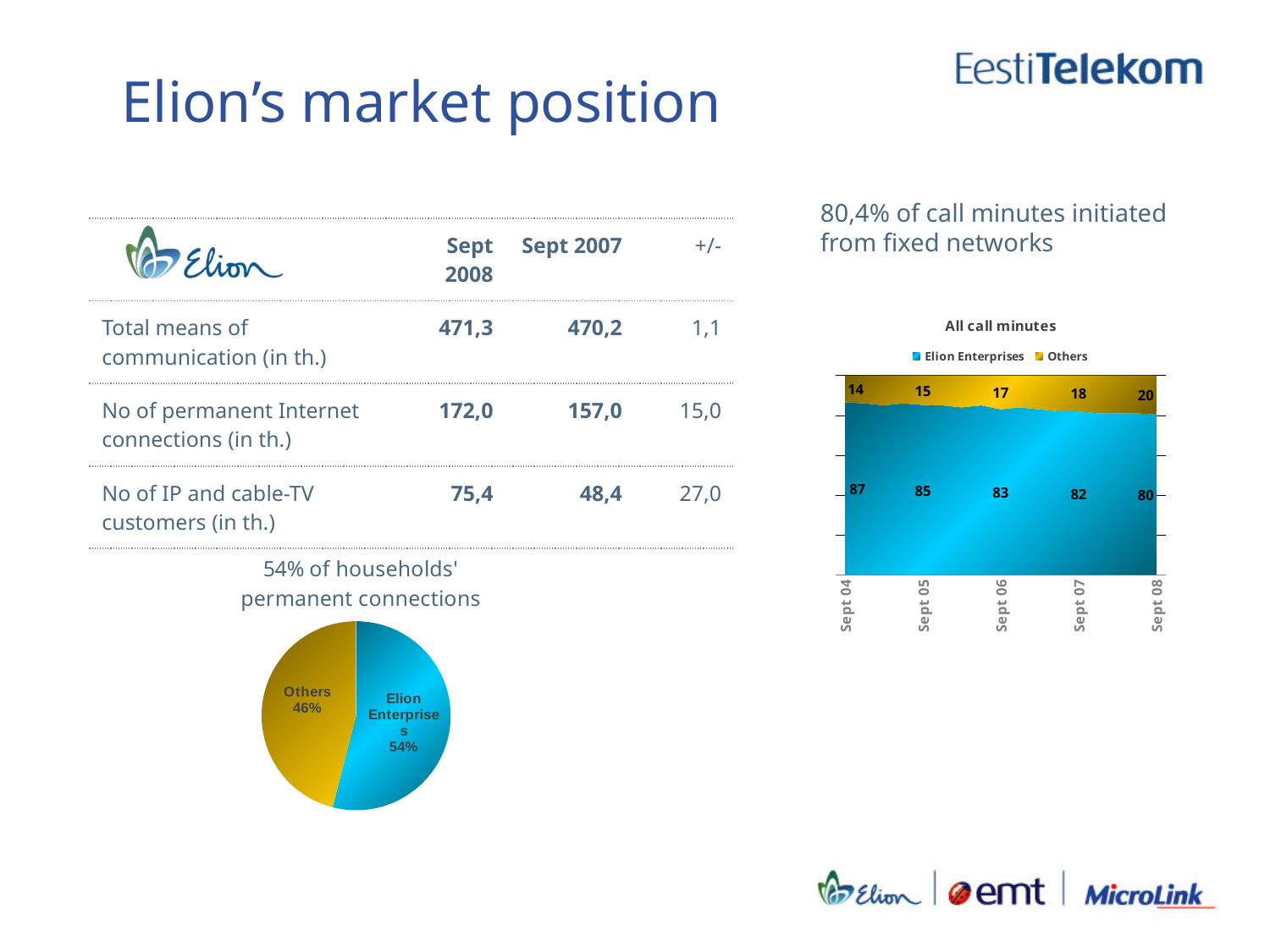
What kind of chart is the chart at the bottom left of the slide? pie chart In the 'All call minutes' chart, in which period is the Others value highest? Sept 08 In the 'All call minutes' chart, what is the difference between the Elion Enterprises values in Sept 04 and Sept 08? 7 In the pie chart titled '54% of households' permanent connections', which slice is larger, Elion Enterprises or Others? Elion Enterprises In the 'All call minutes' chart, what is the value for Elion Enterprises in Sept 04? 87 In the 'All call minutes' chart, how many series does the legend list? 2 In the pie chart titled '54% of households' permanent connections', what share does Others have? 46% In the 'All call minutes' chart, does the Others series rise or fall from Sept 04 to Sept 08? rise In the 'All call minutes' chart, how many periods are shown on the x axis? 5 In the 'All call minutes' chart, in which period is the Elion Enterprises value lowest? Sept 08 In the 'All call minutes' chart, what is the value for Elion Enterprises in Sept 06? 83 In the 'All call minutes' chart, what is the value for Others in Sept 08? 20